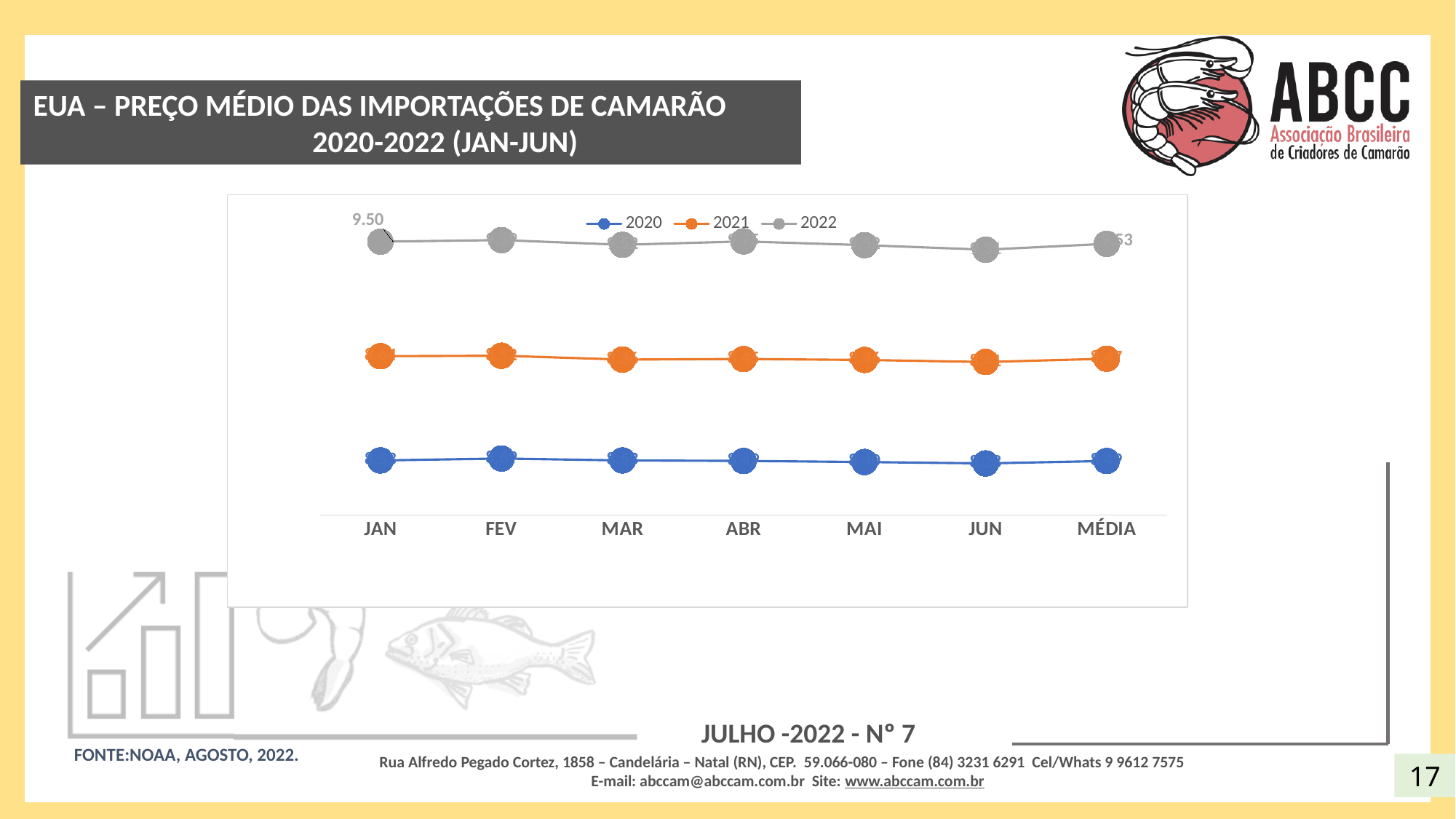
How many categories are shown on the x axis? 7 In JAN, which is larger: the value for 2022 or the value for 2020? 2022 Which series is drawn in orange? 2021 Which years are listed in the chart legend? 2020, 2021, 2022 What kind of chart is shown on the slide? line chart What is the last category on the x axis? MÉDIA How many series does the legend list? 3 Which series has the highest values across all months? 2022 What is the value for 2022 in JAN? 9.50